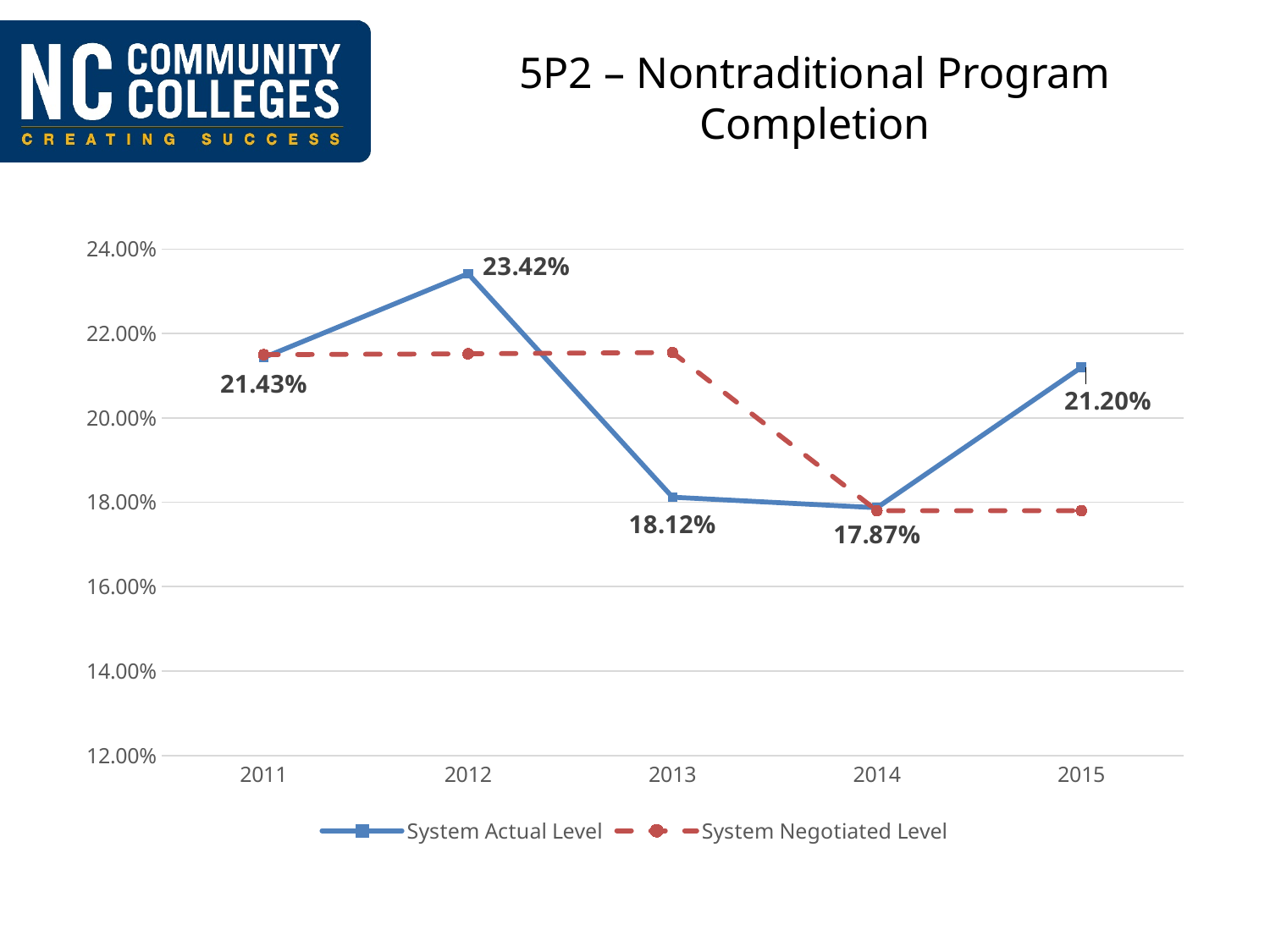
What kind of chart is shown on the slide? Line chart In which year is the System Actual Level lowest? 2014 What is the System Actual Level for 2014? 17.87% What is the System Actual Level for 2012? 23.42% Which year has the larger System Actual Level, 2011 or 2015? 2011 In which year is the System Actual Level highest? 2012 What is the difference between the System Actual Level in 2012 and in 2013? 5.30 percentage points Is the System Negotiated Level for 2015 greater or less than 20.00%? less Is the System Negotiated Level for 2013 greater or less than 20.00%? greater How many series does the legend list? 2 How many years are shown on the x axis? 5 What is the System Actual Level for 2015? 21.20%